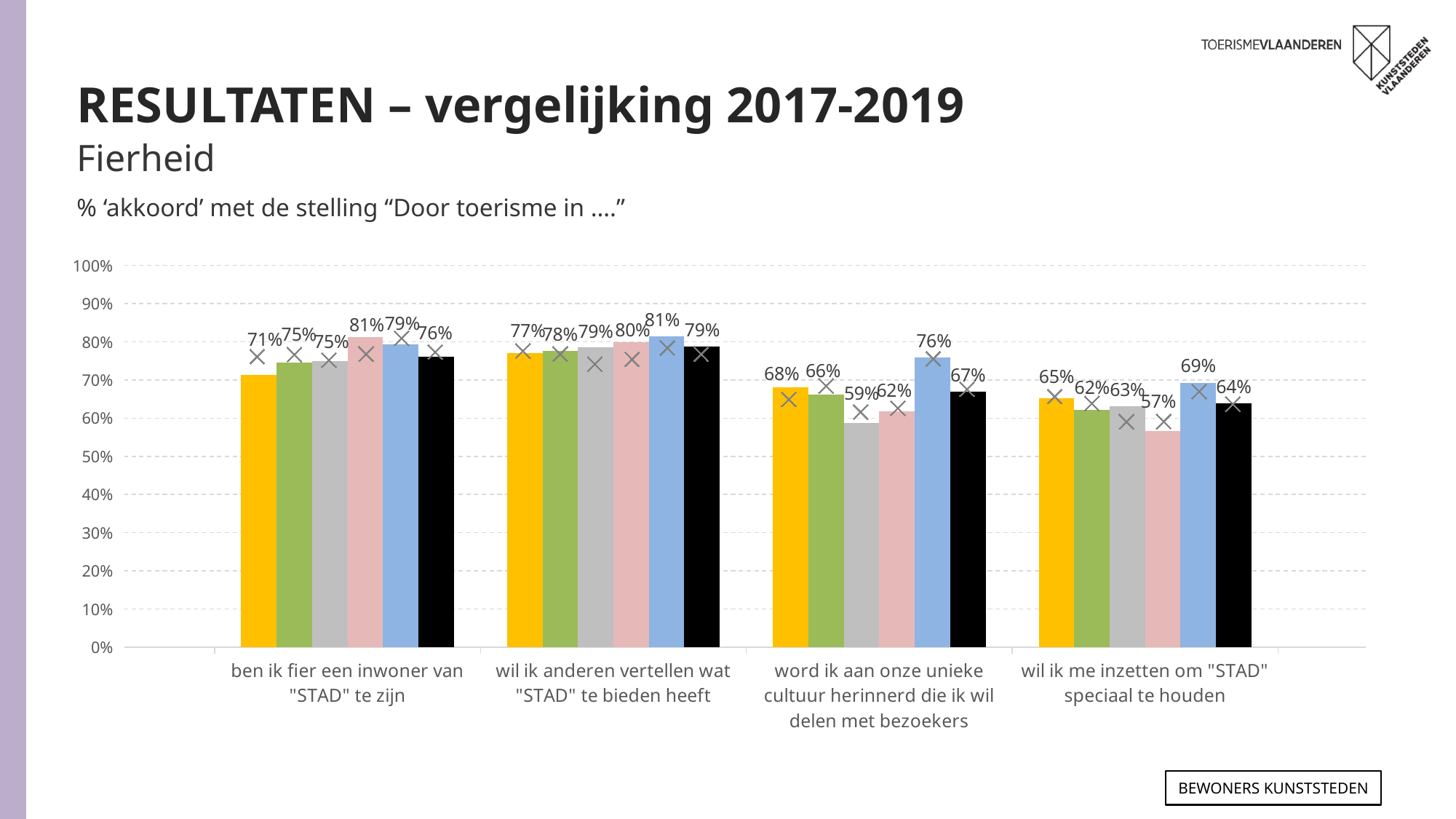
What is the subtitle of the chart describing what the percentages represent? % ‘akkoord’ met de stelling “Door toerisme in ….” For "wil ik me inzetten om "STAD" speciaal te houden", which is larger: the blue bar or the black bar? the blue bar (69%) What is the value of the blue bar for "word ik aan onze unieke cultuur herinnerd die ik wil delen met bezoekers"? 76% Which bar has the lowest value for "word ik aan onze unieke cultuur herinnerd die ik wil delen met bezoekers"? the grey bar (59%) Which bar has the highest value for "wil ik anderen vertellen wat "STAD" te bieden heeft"? the blue bar (81%) How many statement categories are shown along the x axis of the chart? 4 What is the difference between the pink bar (81%) and the yellow bar (71%) for "ben ik fier een inwoner van "STAD" te zijn"? 10 percentage points What is the value of the pink bar for "wil ik me inzetten om "STAD" speciaal te houden"? 57% What is the value of the yellow bar for "ben ik fier een inwoner van "STAD" te zijn"? 71% Is the value of the grey bar for "wil ik me inzetten om "STAD" speciaal te houden" greater or less than 70%? less How many bars are plotted for each statement category in the chart? 6 What type of chart is shown on the slide? bar chart